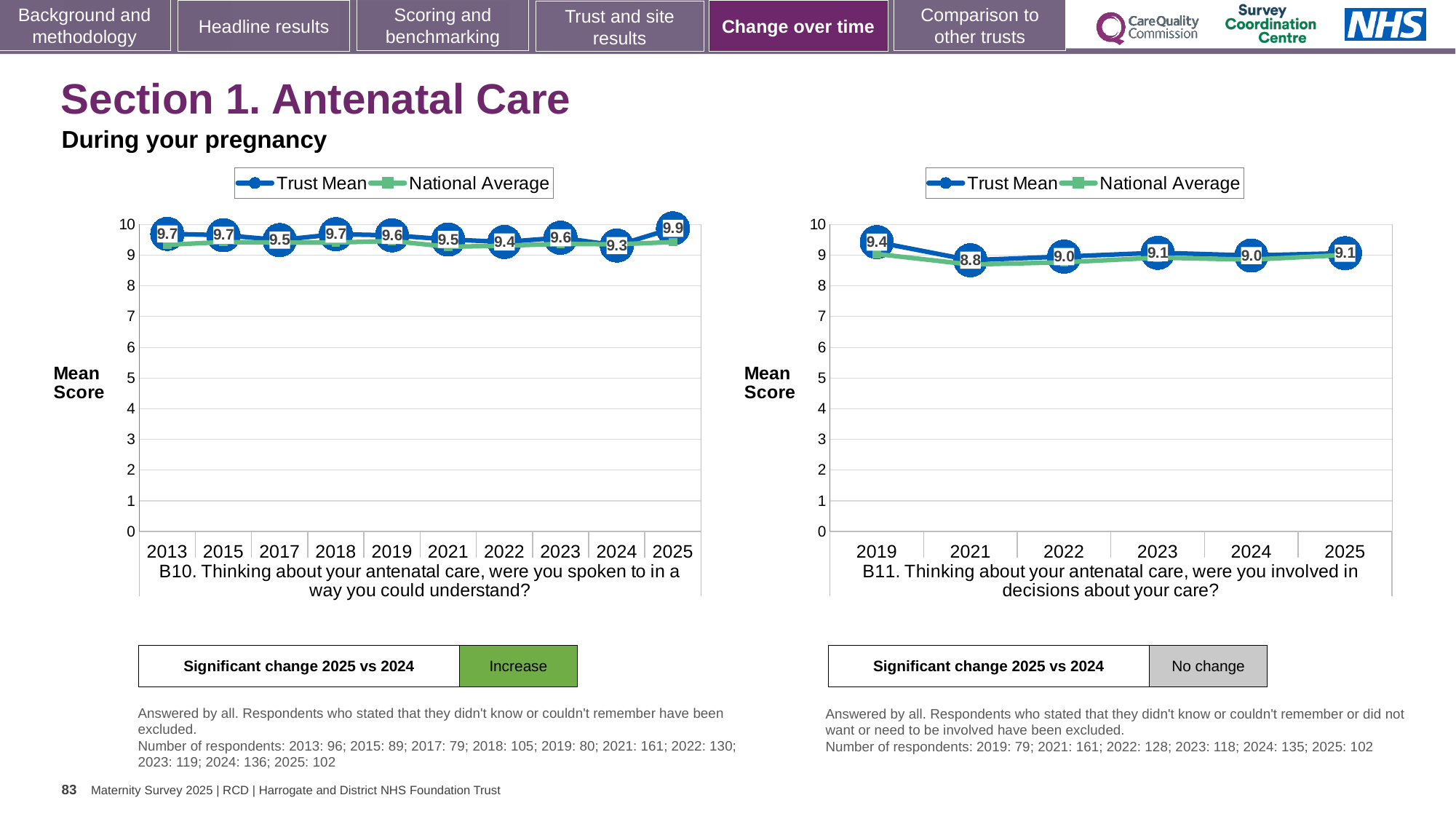
What kind of chart is the right chart (B11)? Line chart How many series does the legend of the right chart (B11) list? 2 In the left chart (B10), what is the Trust Mean score for 2025? 9.9 What does the 'Significant change 2025 vs 2024' box below the left chart (B10) say? Increase How many years are plotted on the x axis of the left chart (B10)? 10 In the right chart (B11), what is the difference between the Trust Mean scores for 2019 and 2021? 0.6 In the right chart (B11), what is the Trust Mean score for 2021? 8.8 In the left chart (B10), which year has the lowest Trust Mean score? 2024 In the left chart (B10), is the National Average value for 2019 greater or less than 9? greater In the right chart (B11), which year has the highest Trust Mean score? 2019 In the left chart (B10), which year has the highest Trust Mean score? 2025 In the left chart (B10), is the Trust Mean score higher in 2013 or in 2024? 2013